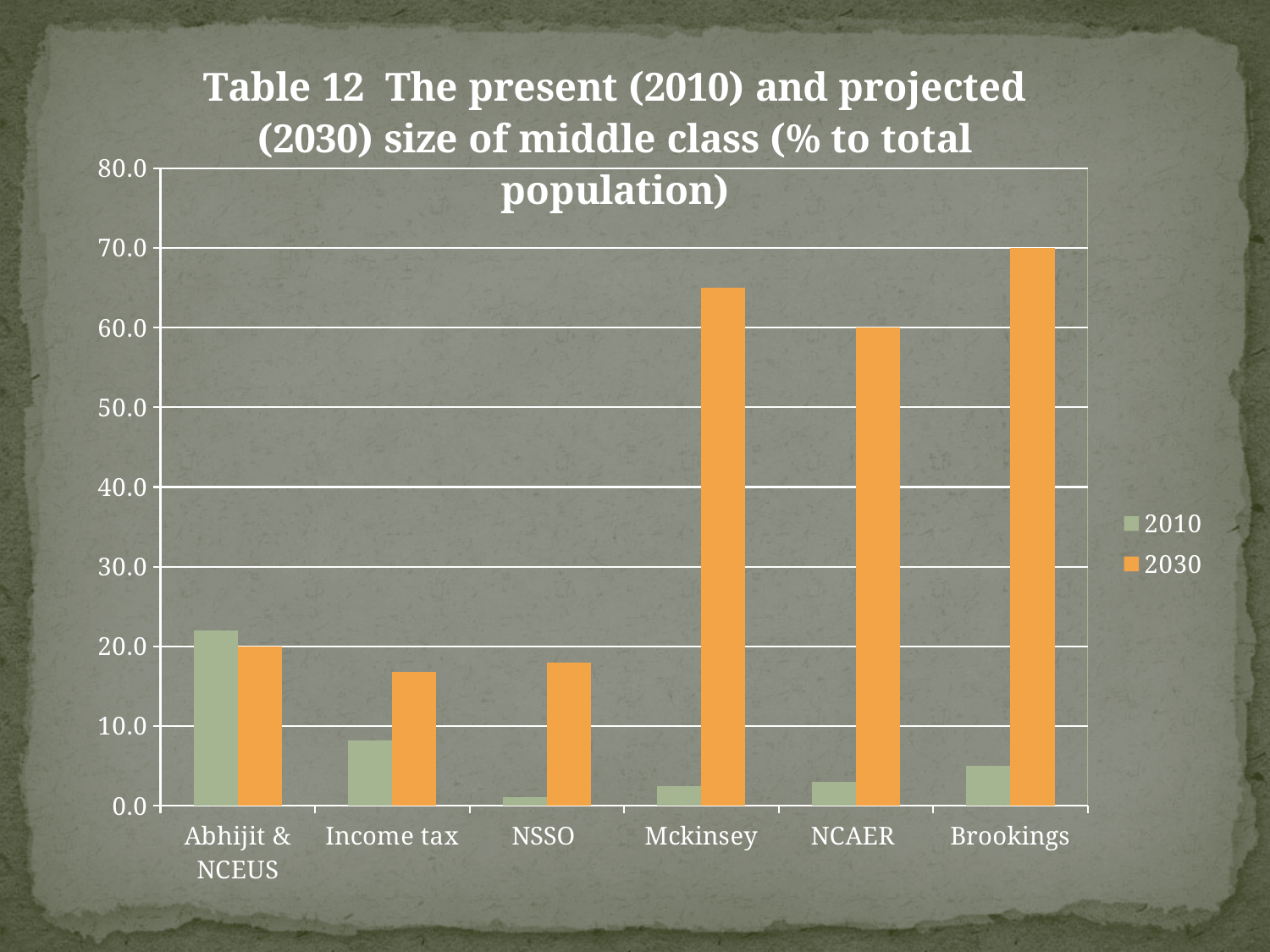
For Abhijit & NCEUS, which is larger: the 2010 value or the 2030 value? 2010 What kind of chart is shown on the slide? bar chart What is the 2030 value for NCAER? 60.0 What is the 2030 value for Abhijit & NCEUS? 20.0 Is the 2010 value for Income tax greater or less than 10.0? less Which category has the highest 2010 value? Abhijit & NCEUS What is the difference between the 2030 values for Brookings and NCAER? 10.0 What is the 2030 value for Brookings? 70.0 Which category has the highest 2030 value? Brookings How many series does the legend list? 2 How many categories are shown on the x axis? 6 Is the 2030 value for Mckinsey greater or less than 60.0? greater